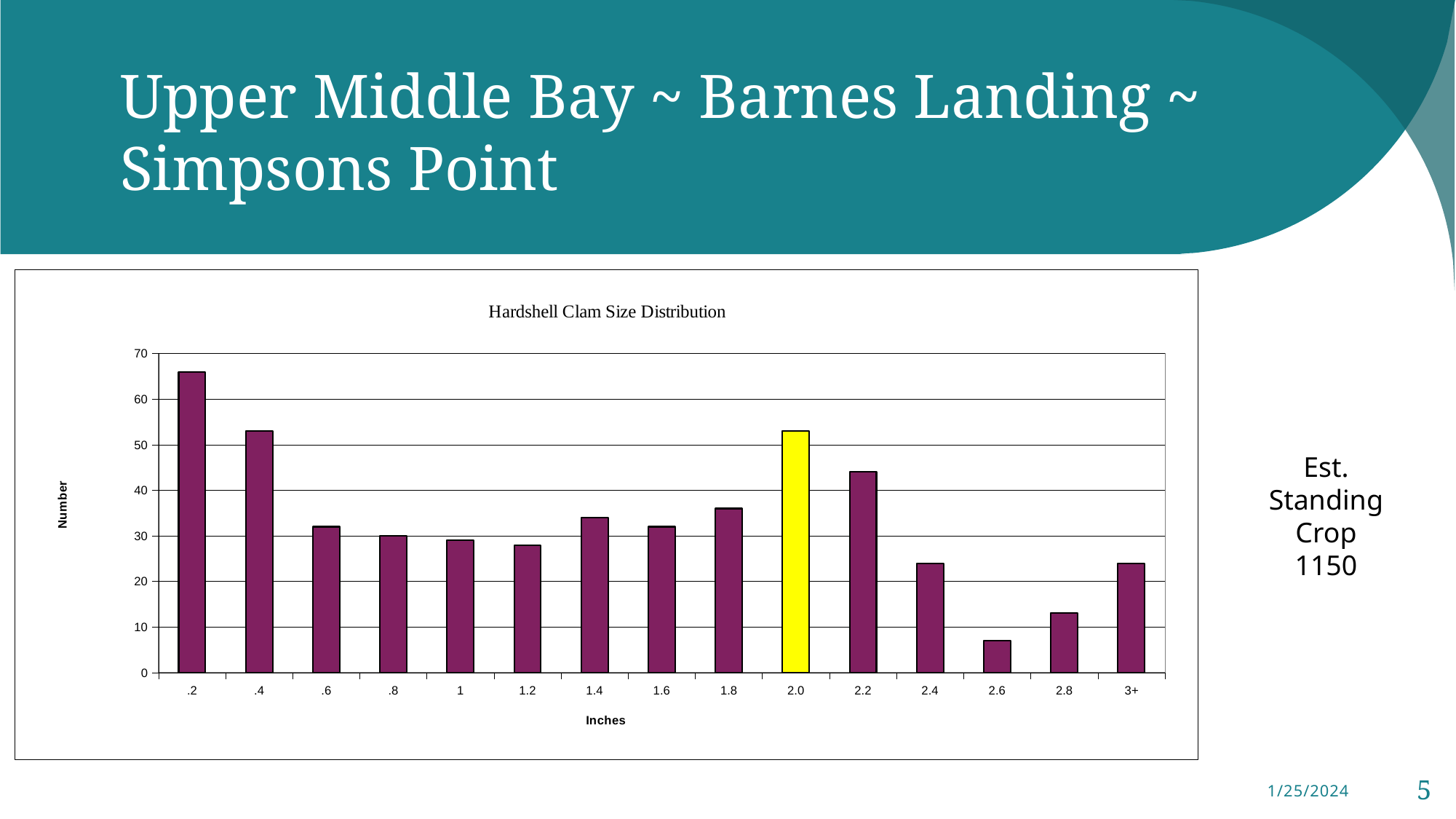
Which has a larger value, the .4 inch category or the .6 inch category? .4 Which size category has the lowest number of clams? 2.6 Which size category has the highest number of clams? .2 Is the value for the .2 inch category greater or less than 60? greater What is the label on the y axis of the chart? Number What kind of chart is the Hardshell Clam Size Distribution chart? bar chart How many size categories are shown on the x axis? 15 Is the value for the 2.8 inch category greater or less than 20? less Which has a larger value, the 2.2 inch category or the 2.4 inch category? 2.2 Is the value for the 2.6 inch category greater or less than 10? less Which bar is highlighted in yellow? 2.0